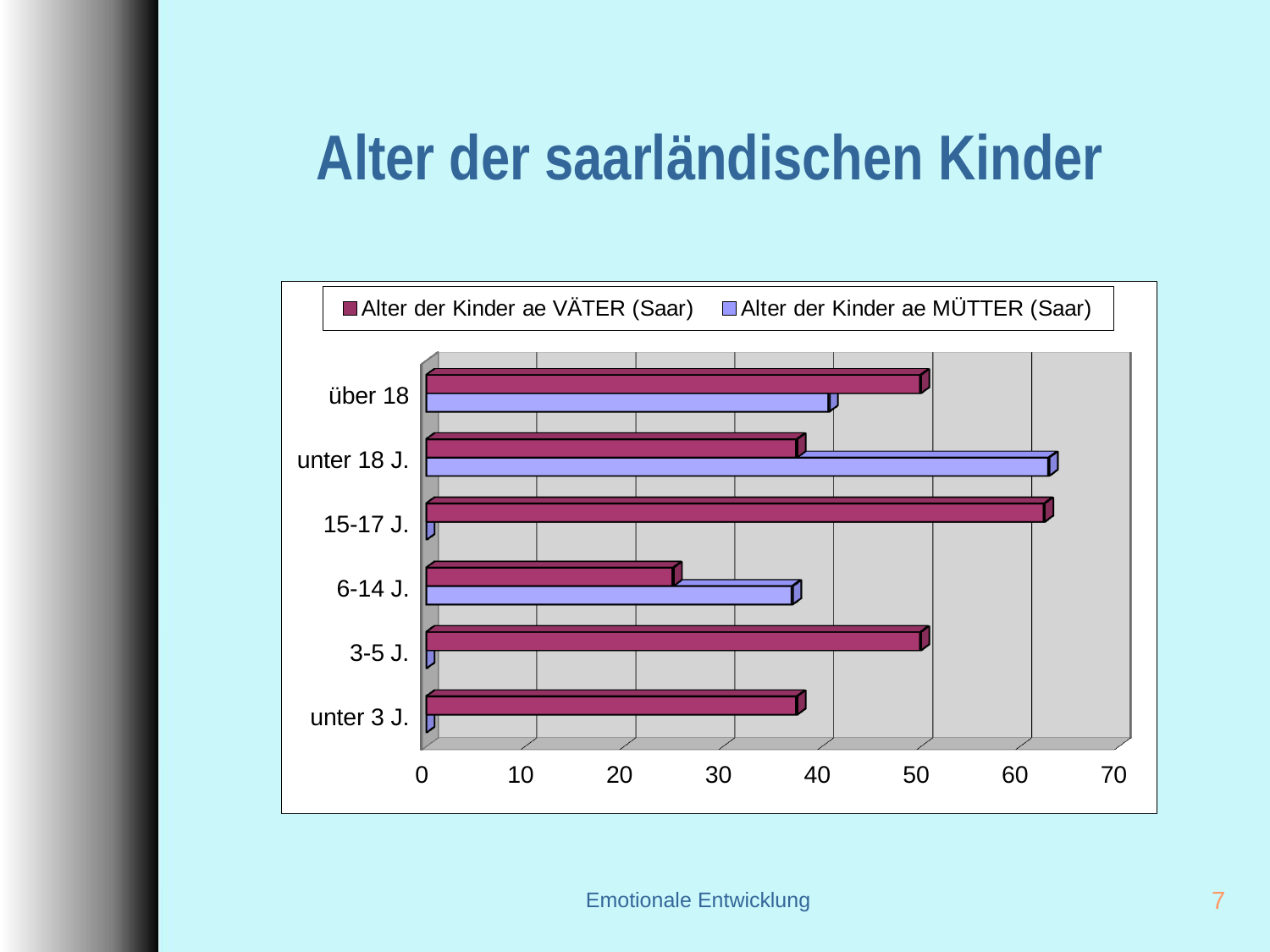
Is the value for 6-14 J. in the series Alter der Kinder ae VÄTER (Saar) greater or less than 30? less For the category über 18, which series has the larger value, VÄTER or MÜTTER? VÄTER What kind of chart is shown on the slide? bar chart How many series does the legend list? 2 Which category has the highest value for the series Alter der Kinder ae VÄTER (Saar)? 15-17 J. Which legend entry is shown in the dark red colour? Alter der Kinder ae VÄTER (Saar) Is the value for 15-17 J. in the series Alter der Kinder ae VÄTER (Saar) greater or less than 60? greater Which category has the highest value for the series Alter der Kinder ae MÜTTER (Saar)? unter 18 J. What is the title of the slide containing the chart? Alter der saarländischen Kinder For the category 6-14 J., which series has the larger value, VÄTER or MÜTTER? MÜTTER How many age categories are shown on the vertical axis? 6 Which category has the lowest value for the series Alter der Kinder ae VÄTER (Saar)? 6-14 J.